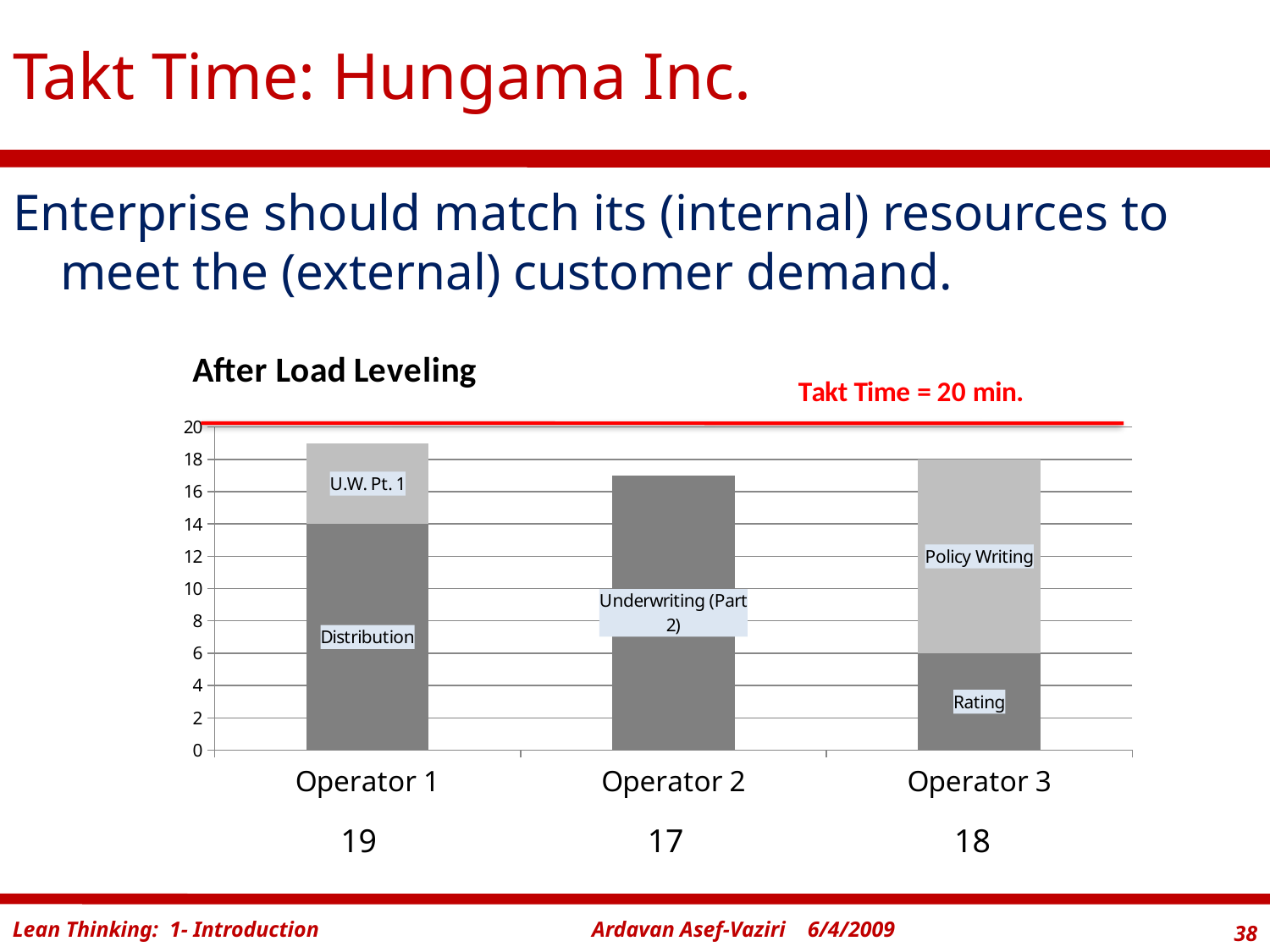
What kind of chart is shown on the slide? Stacked bar chart Which operator has the lowest total time? Operator 2 Which is larger, the total time for Operator 3 or Operator 2? Operator 3 What is the total time for Operator 1? 19 What is the total time for Operator 3? 18 What is the Takt Time indicated by the red line on the chart? 20 min. How many operators are shown on the x axis? 3 What is the total time for Operator 2? 17 Is the value for the Rating segment of Operator 3 greater or less than 10? less What is the difference between the total time for Operator 1 and Operator 2? 2 Which operator has the highest total time? Operator 1 Is the total time for Operator 1 greater or less than 20? less